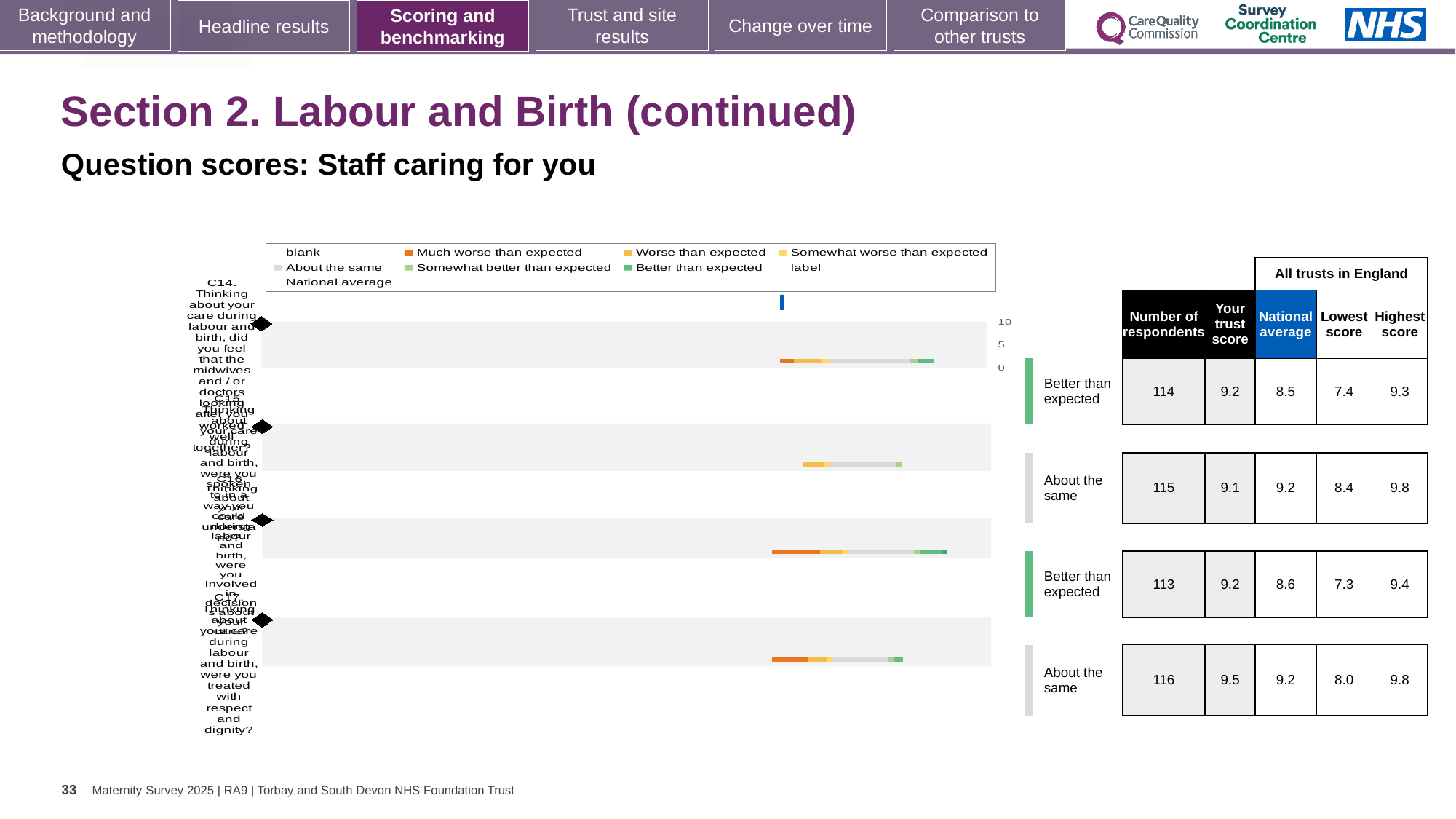
What benchmark label is given for the bottom row (C17) next to the chart? About the same Which row has the highest 'Your trust score' in the table beside the chart? C17 (treated with respect and dignity), 9.5 How many of the four rows are labelled 'Better than expected'? 2 In the table beside the chart, what is the national average for the top row (C14)? 8.5 What does the blue marker in the legend represent? National average Which legend entry is shown in orange? Much worse than expected In the table beside the chart, what is the number of respondents for the top row (C14, midwives and/or doctors worked well together)? 114 How many question rows (bars) are plotted in the chart? 4 In the table beside the chart, what is the 'Your trust score' for the bottom row (C17, treated with respect and dignity)? 9.5 For the top row (C14), what is the difference between the highest score (9.3) and the lowest score (7.4) in the table? 1.9 For the top row (C14), which is larger: the trust score or the national average? Your trust score (9.2) What type of chart is shown on the slide? bar chart